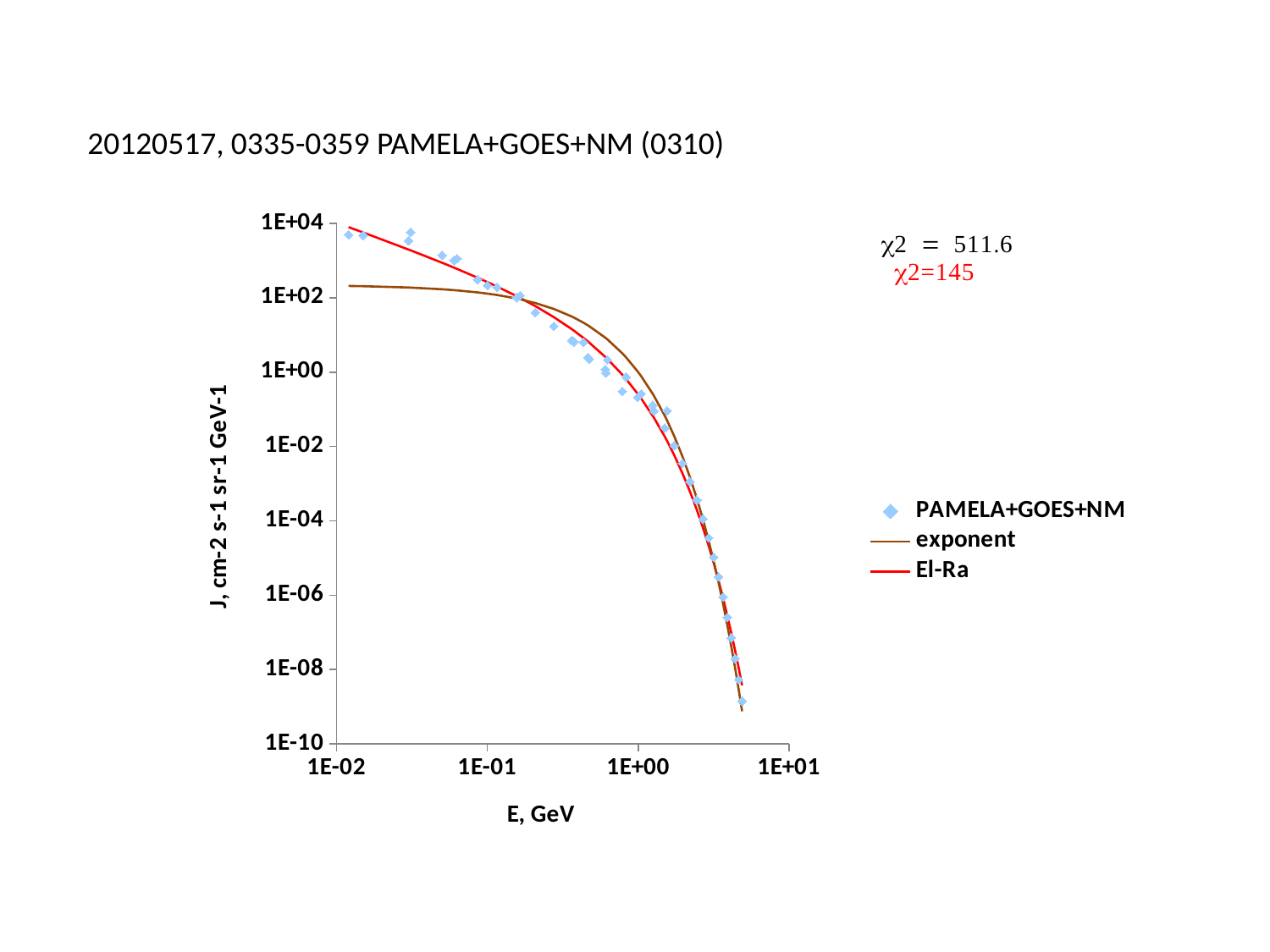
What colour is the El-Ra line in the chart? Red At E = 1E-02 GeV, which curve is higher, exponent or El-Ra? El-Ra How many series does the legend list? 3 How many tick labels are shown on the x axis? 4 How many tick labels are shown on the y axis? 8 At E = 1E-02 GeV, is the exponent curve greater or less than 1E+04? less What kind of chart is shown on the slide? Scatter chart with fitted lines on log axes Near E = 5E+00 GeV, is the PAMELA+GOES+NM value greater or less than 1E-06? less Do the PAMELA+GOES+NM values rise or fall as E increases along the x axis? Fall What is the label of the x axis? E, GeV At E = 1E-02 GeV, is the PAMELA+GOES+NM value greater or less than 1E+02? greater At E = 1E+00 GeV, which curve is higher, exponent or El-Ra? exponent